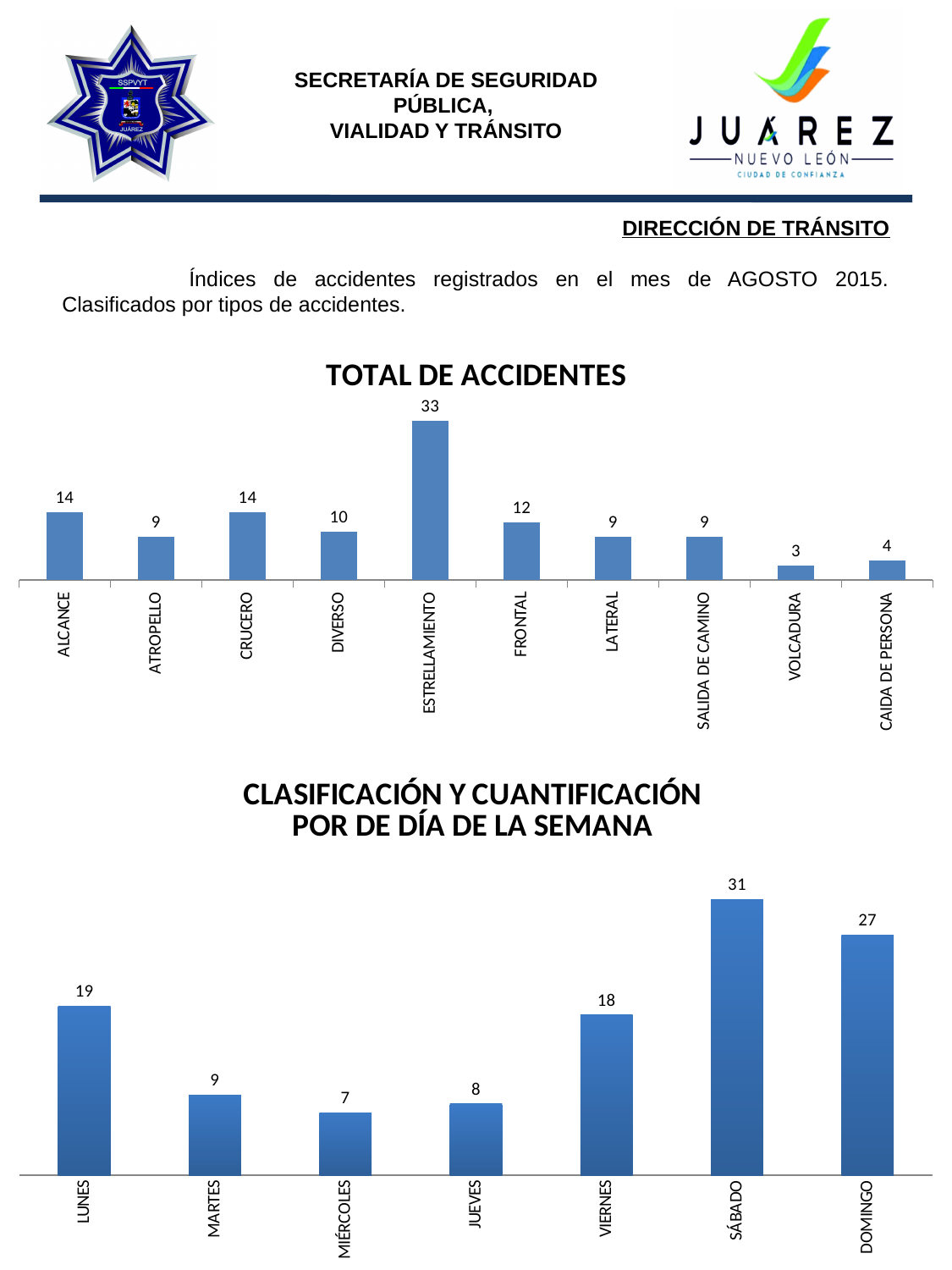
In the "CLASIFICACIÓN Y CUANTIFICACIÓN POR DE DÍA DE LA SEMANA" chart, what is the value for MIÉRCOLES? 7 In the "CLASIFICACIÓN Y CUANTIFICACIÓN POR DE DÍA DE LA SEMANA" chart, what is the difference between SÁBADO and DOMINGO? 4 What kind of chart is the "CLASIFICACIÓN Y CUANTIFICACIÓN POR DE DÍA DE LA SEMANA" chart? Bar chart In the "TOTAL DE ACCIDENTES" chart, what is the value for CAIDA DE PERSONA? 4 In the "TOTAL DE ACCIDENTES" chart, what is the value for ESTRELLAMIENTO? 33 In the "CLASIFICACIÓN Y CUANTIFICACIÓN POR DE DÍA DE LA SEMANA" chart, how many days are shown? 7 In the "CLASIFICACIÓN Y CUANTIFICACIÓN POR DE DÍA DE LA SEMANA" chart, which is larger, LUNES or VIERNES? LUNES In the "TOTAL DE ACCIDENTES" chart, how many categories are shown? 10 In the "TOTAL DE ACCIDENTES" chart, what is the difference between ESTRELLAMIENTO and FRONTAL? 21 In the "TOTAL DE ACCIDENTES" chart, which is larger, DIVERSO or LATERAL? DIVERSO In the "TOTAL DE ACCIDENTES" chart, which category has the lowest value? VOLCADURA In the "CLASIFICACIÓN Y CUANTIFICACIÓN POR DE DÍA DE LA SEMANA" chart, which day has the highest value? SÁBADO